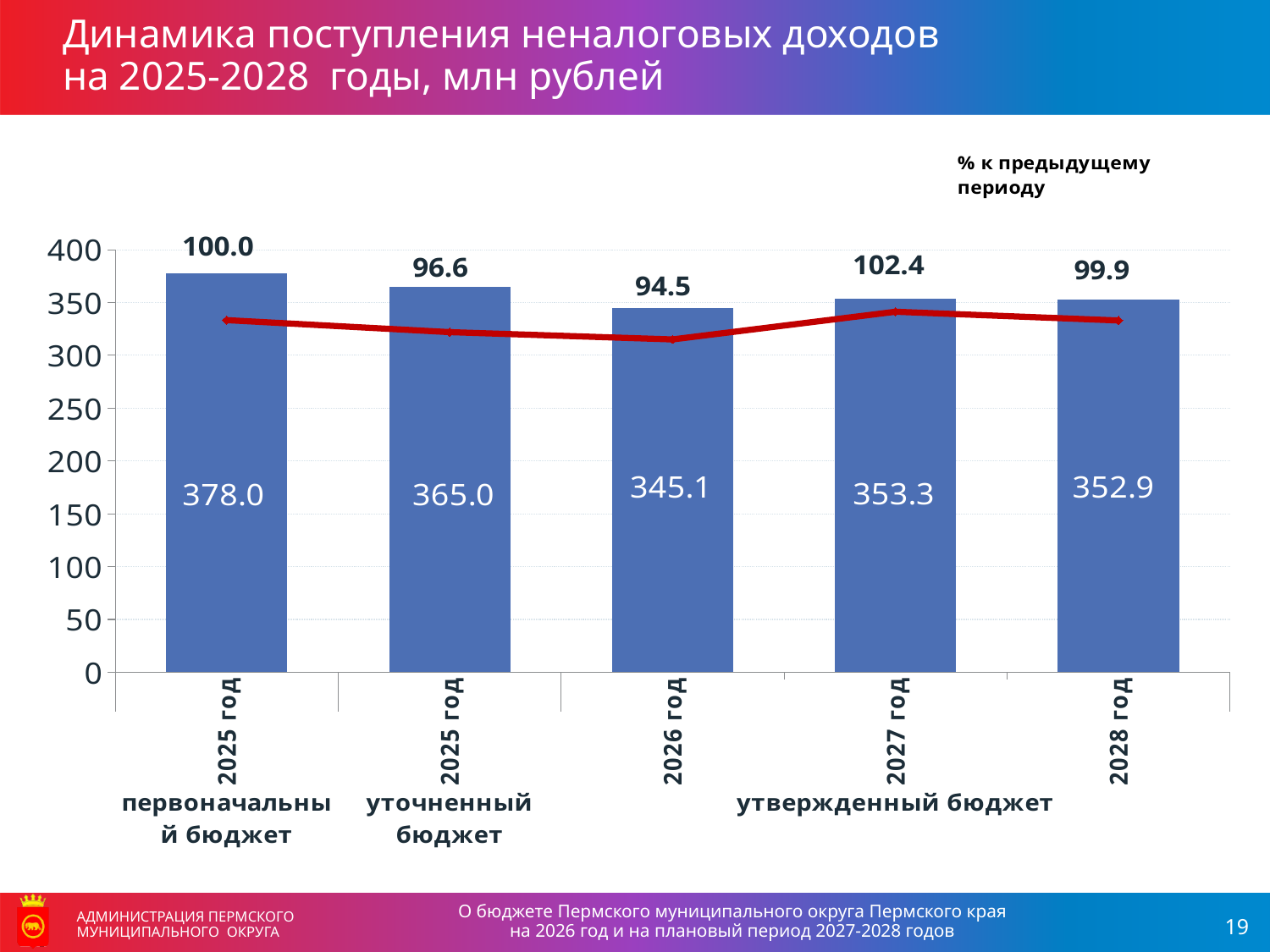
What is the '% к предыдущему периоду' value shown for 2026 год? 94.5 Which category has the highest bar value? 2025 год (первоначальный бюджет) How many bars are plotted on the chart? 5 Which is larger, the bar value for 2027 год or for 2026 год? 2027 год What is the difference between the bar values for 2025 год (первоначальный бюджет) and 2025 год (уточненный бюджет)? 13.0 Which category has the lowest bar value? 2026 год What is the value of non-tax revenue for 2028 год? 352.9 What is the title of the chart on the slide? Динамика поступления неналоговых доходов на 2025-2028 годы, млн рублей What is the '% к предыдущему периоду' value shown for 2027 год? 102.4 What is the value of non-tax revenue for 2026 год? 345.1 What is the value of non-tax revenue for 2025 год (первоначальный бюджет)? 378.0 What kind of chart is shown on the slide? Bar chart with a line